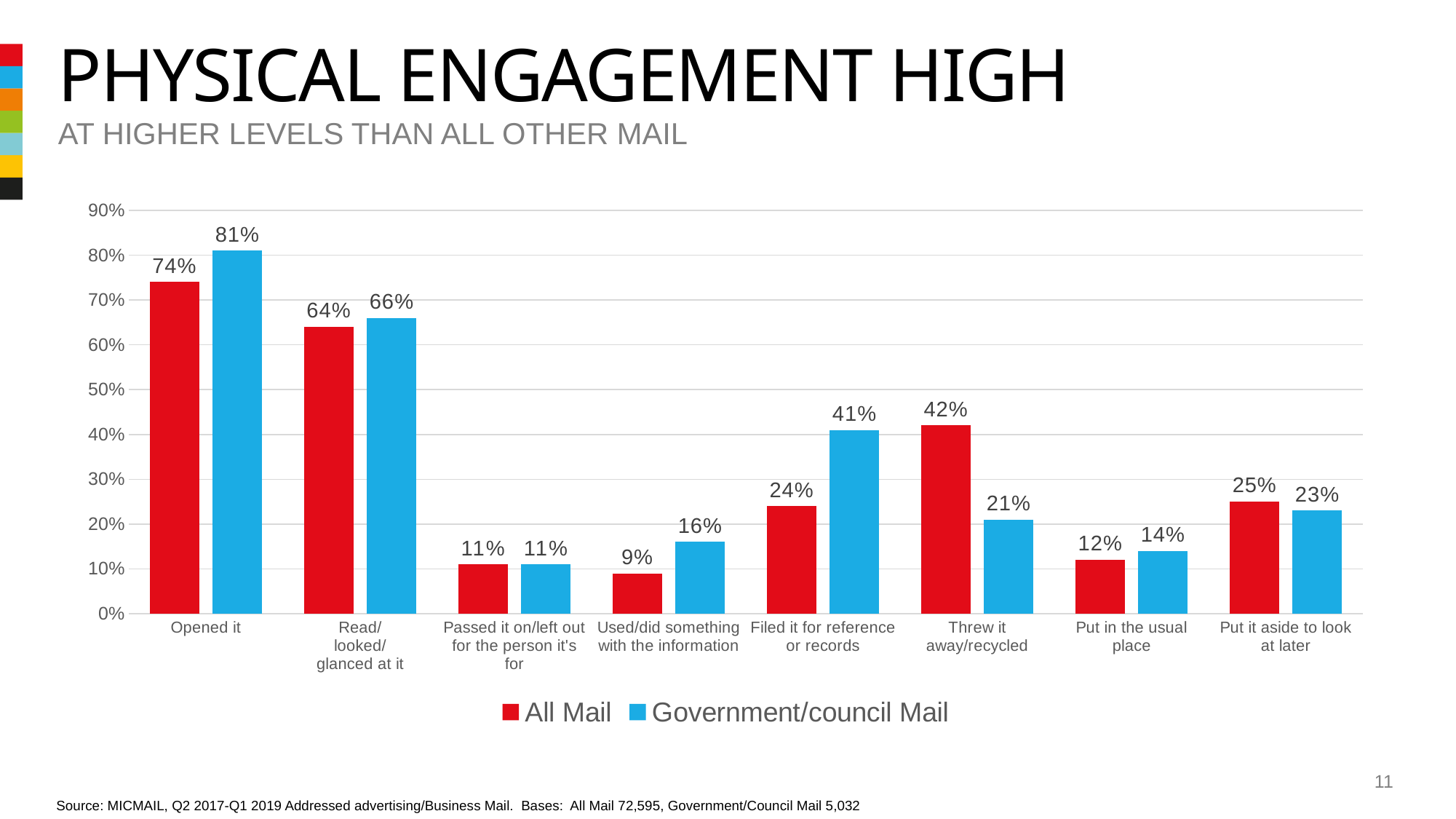
Is the value for Government/council Mail for "Read/looked/glanced at it" greater or less than 60%? greater What is the value for Government/council Mail for "Opened it"? 81% What is the value for All Mail for "Threw it away/recycled"? 42% How many series does the legend list? 2 What kind of chart is shown on the slide? Bar chart What is the value for Government/council Mail for "Filed it for reference or records"? 41% Which colour represents Government/council Mail in the chart? Blue What is the difference between Government/council Mail and All Mail for "Filed it for reference or records"? 17% Which is larger for "Threw it away/recycled": All Mail or Government/council Mail? All Mail Which category has the highest value for All Mail? Opened it How many categories are shown on the x axis? 8 Which category has the lowest value for All Mail? Used/did something with the information